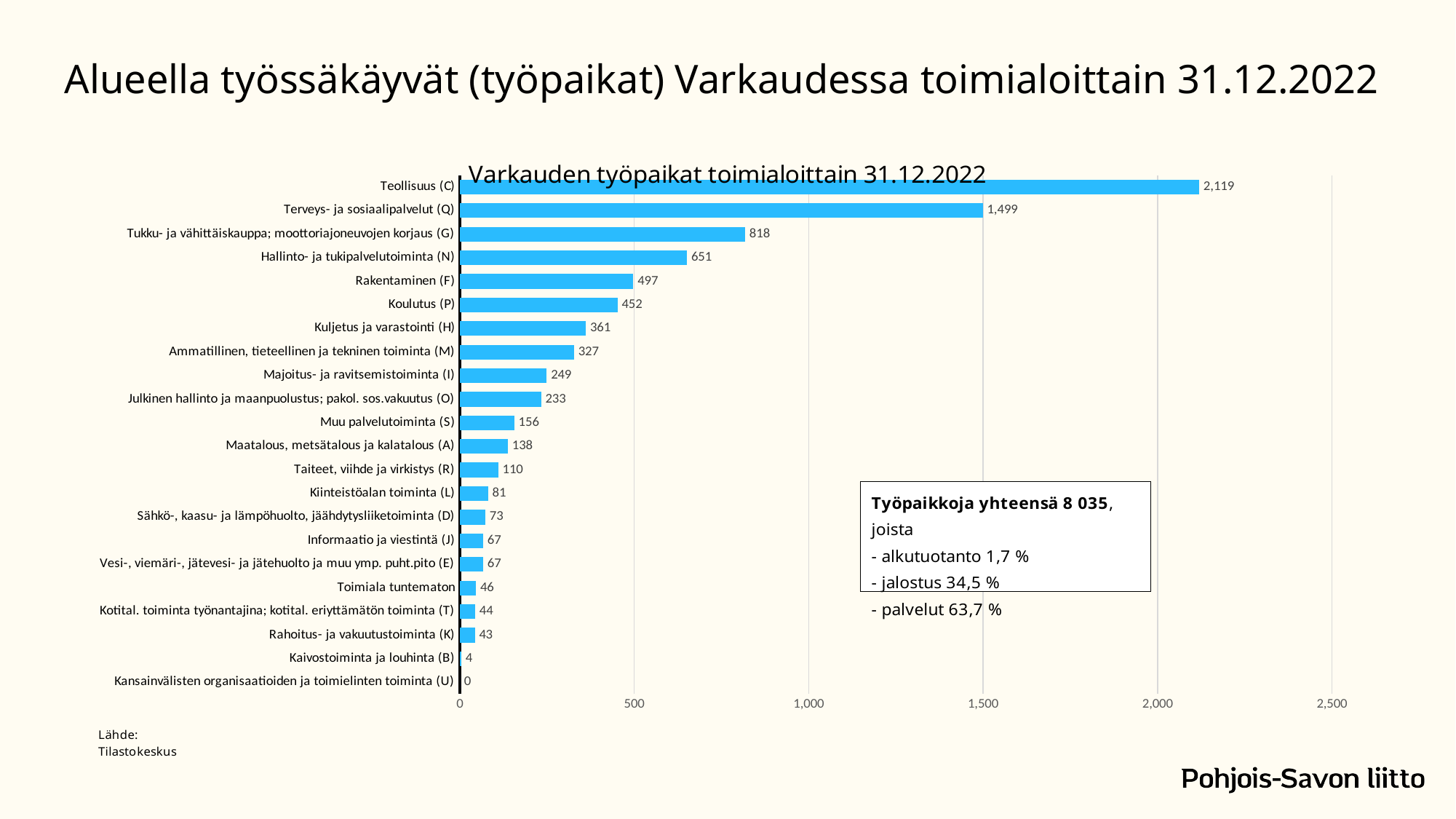
What is the value for Teollisuus (C)? 2,119 What is the title of the chart? Varkauden työpaikat toimialoittain 31.12.2022 Which is larger, Kuljetus ja varastointi (H) or Majoitus- ja ravitsemistoiminta (I)? Kuljetus ja varastointi (H) What is the difference between Rakentaminen (F) and Koulutus (P)? 45 Which category has the highest value? Teollisuus (C) What kind of chart is shown on the slide? bar chart Which category has the lowest value? Kansainvälisten organisaatioiden ja toimielinten toiminta (U) What is the value for Koulutus (P)? 452 What is the difference between Teollisuus (C) and Terveys- ja sosiaalipalvelut (Q)? 620 How many categories are shown in the chart? 22 What is the value for Rahoitus- ja vakuutustoiminta (K)? 43 Is the value for Hallinto- ja tukipalvelutoiminta (N) greater or less than 500? greater